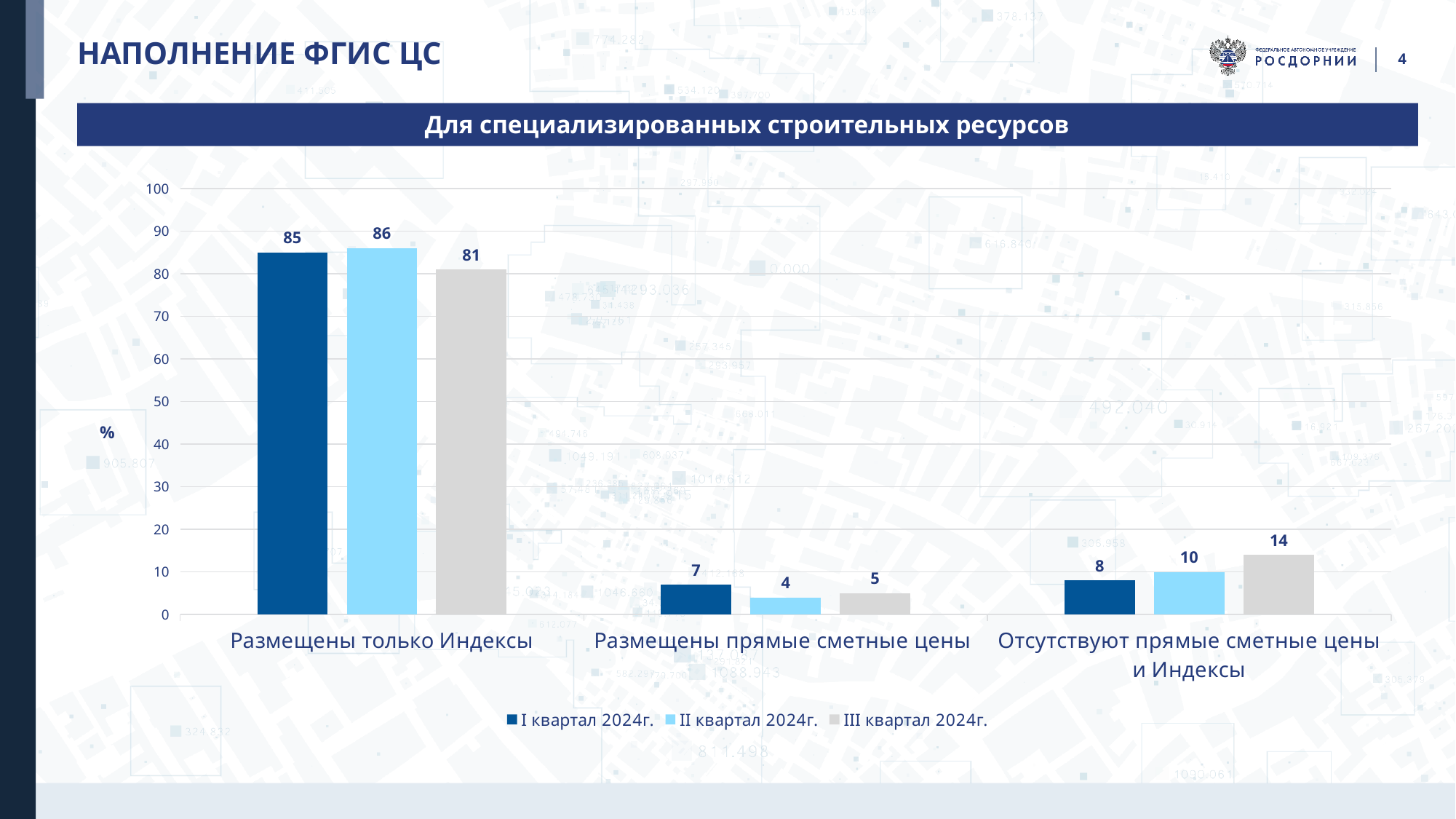
How many series does the legend list? 3 Which category has the highest value in the 'III квартал 2024г.' series? Размещены только Индексы Is the value for 'Размещены только Индексы' in the 'I квартал 2024г.' series greater or less than 80? greater What is the value for 'Размещены прямые сметные цены' in the 'I квартал 2024г.' series? 7 Which category has the lowest value in the 'II квартал 2024г.' series? Размещены прямые сметные цены Which is larger for 'Отсутствуют прямые сметные цены и Индексы': the 'I квартал 2024г.' value or the 'II квартал 2024г.' value? II квартал 2024г. What is the value for 'Размещены только Индексы' in the 'II квартал 2024г.' series? 86 What is the title shown above the chart? Для специализированных строительных ресурсов How many categories are shown on the x axis? 3 What is the difference between the 'I квартал 2024г.' and 'III квартал 2024г.' values for 'Размещены только Индексы'? 4 What kind of chart is shown on the slide? bar chart What is the value for 'Отсутствуют прямые сметные цены и Индексы' in the 'III квартал 2024г.' series? 14